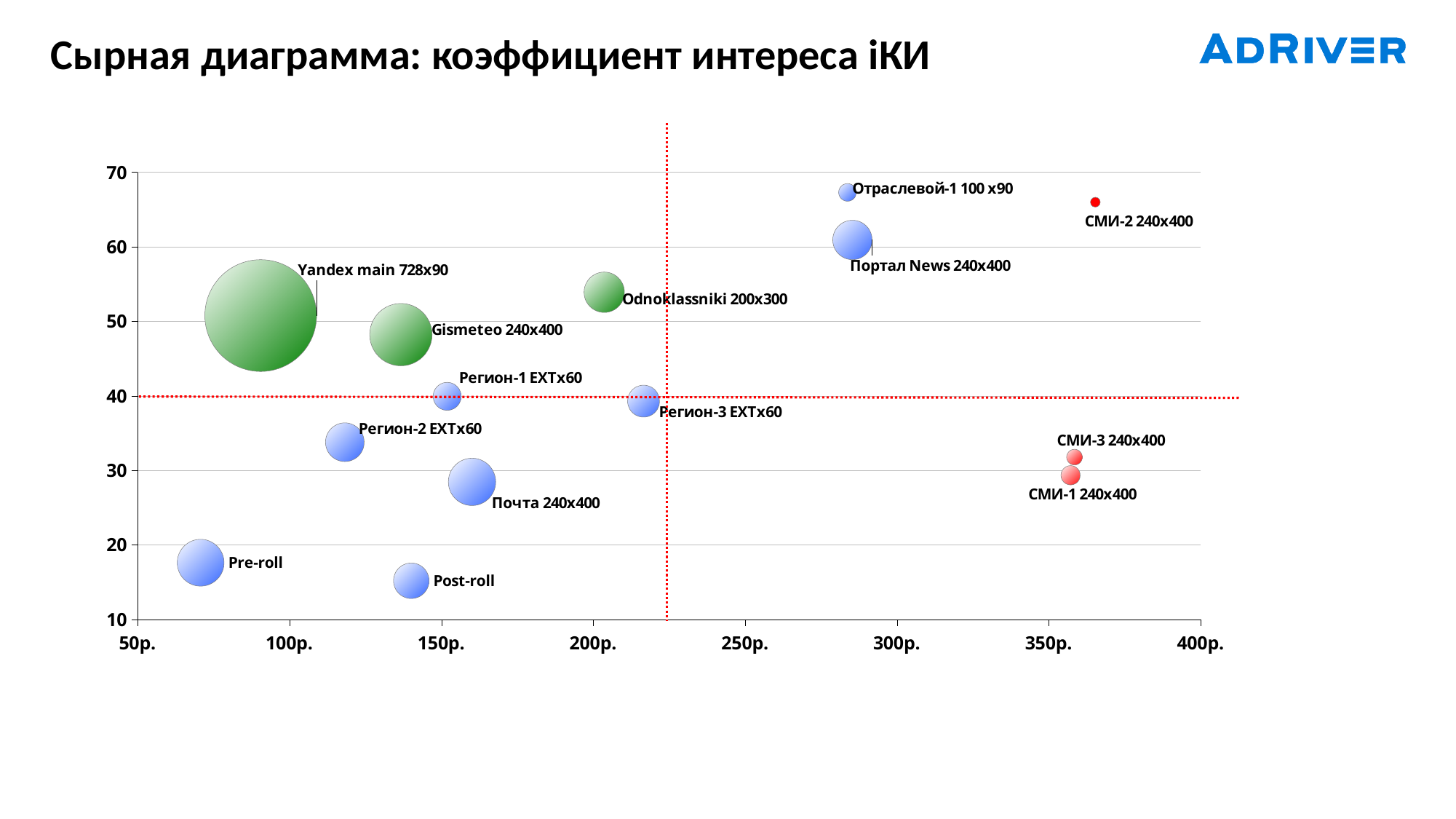
Which has the higher vertical-axis value, Odnoklassniki 200x300 or Почта 240x400? Odnoklassniki 200x300 What is the title of the chart on the slide? Сырная диаграмма: коэффициент интереса iКИ How many labelled bubbles are plotted on the chart? 14 Which bubble is positioned furthest to the right on the horizontal axis? СМИ-2 240x400 Which bubble has the lowest vertical-axis value? Post-roll Is the horizontal-axis value for СМИ-2 240x400 greater or less than 350р.? greater Is the vertical-axis value for Pre-roll greater or less than 20? less Which bubble is positioned furthest to the left on the horizontal axis? Pre-roll Which bubble is the largest on the chart? Yandex main 728x90 What kind of chart is shown on the slide? bubble chart Is the horizontal-axis value for Yandex main 728x90 greater or less than 100р.? less